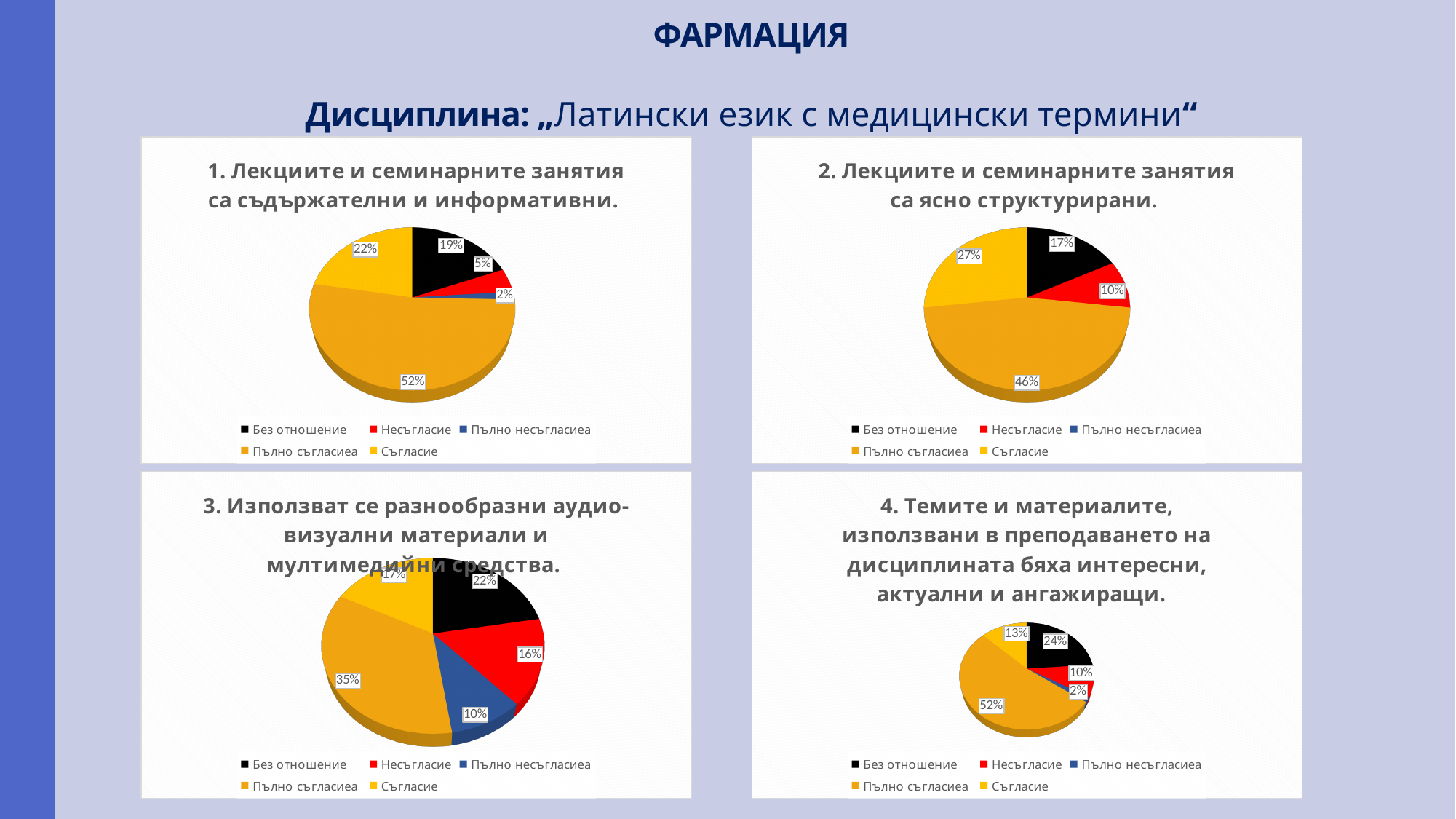
In chart 3 ("Използват се разнообразни аудио-визуални материали и мултимедийни средства"), what percentage is shown for "Несъгласие"? 16% In chart 2 ("Лекциите и семинарните занятия са ясно структурирани"), what percentage is shown for "Съгласие"? 27% How many entries does the legend of chart 2 (top right) list? 5 In chart 1 (top left), what percentage is shown for "Без отношение"? 19% In chart 4 (bottom right), what percentage is shown for "Без отношение"? 24% In chart 1 (top left), what is the difference between the "Съгласие" and "Несъгласие" percentages? 17% In chart 1 ("Лекциите и семинарните занятия са съдържателни и информативни"), what share is labelled for the "Пълно съгласиеа" slice? 52% In chart 3 (bottom left), which category has the smallest slice? Пълно несъгласиеа What type of chart is used in each of the four panels on the slide? Pie chart In chart 2 (top right), which category has the largest slice? Пълно съгласиеа In chart 3 (bottom left), what is the difference between the "Пълно съгласиеа" and "Без отношение" percentages? 13% In chart 4 (bottom right), which is larger: the "Съгласие" slice or the "Несъгласие" slice? Съгласие